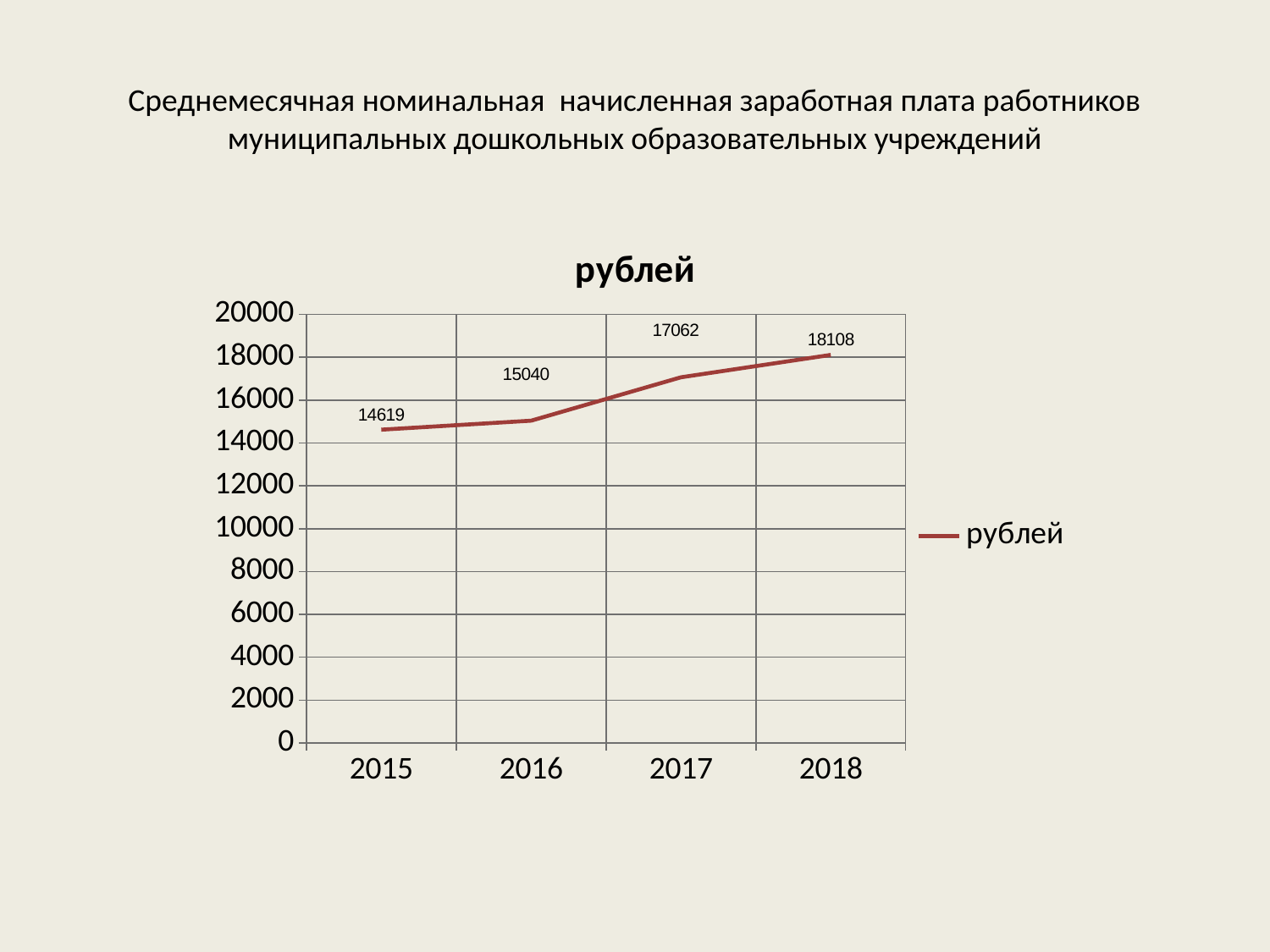
Is the value for 2016 greater or less than 16000? less What is the value for 2017? 17062 What is the value for 2015? 14619 How many years are plotted on the x axis? 4 Do the values rise or fall from 2015 to 2018? rise Which year has the highest value? 2018 Which year has the lowest value? 2015 Which is larger, the value for 2016 or the value for 2017? 2017 What is the difference between the values for 2018 and 2015? 3489 What is the value for 2018? 18108 What is the difference between the values for 2017 and 2016? 2022 What kind of chart is shown? line chart